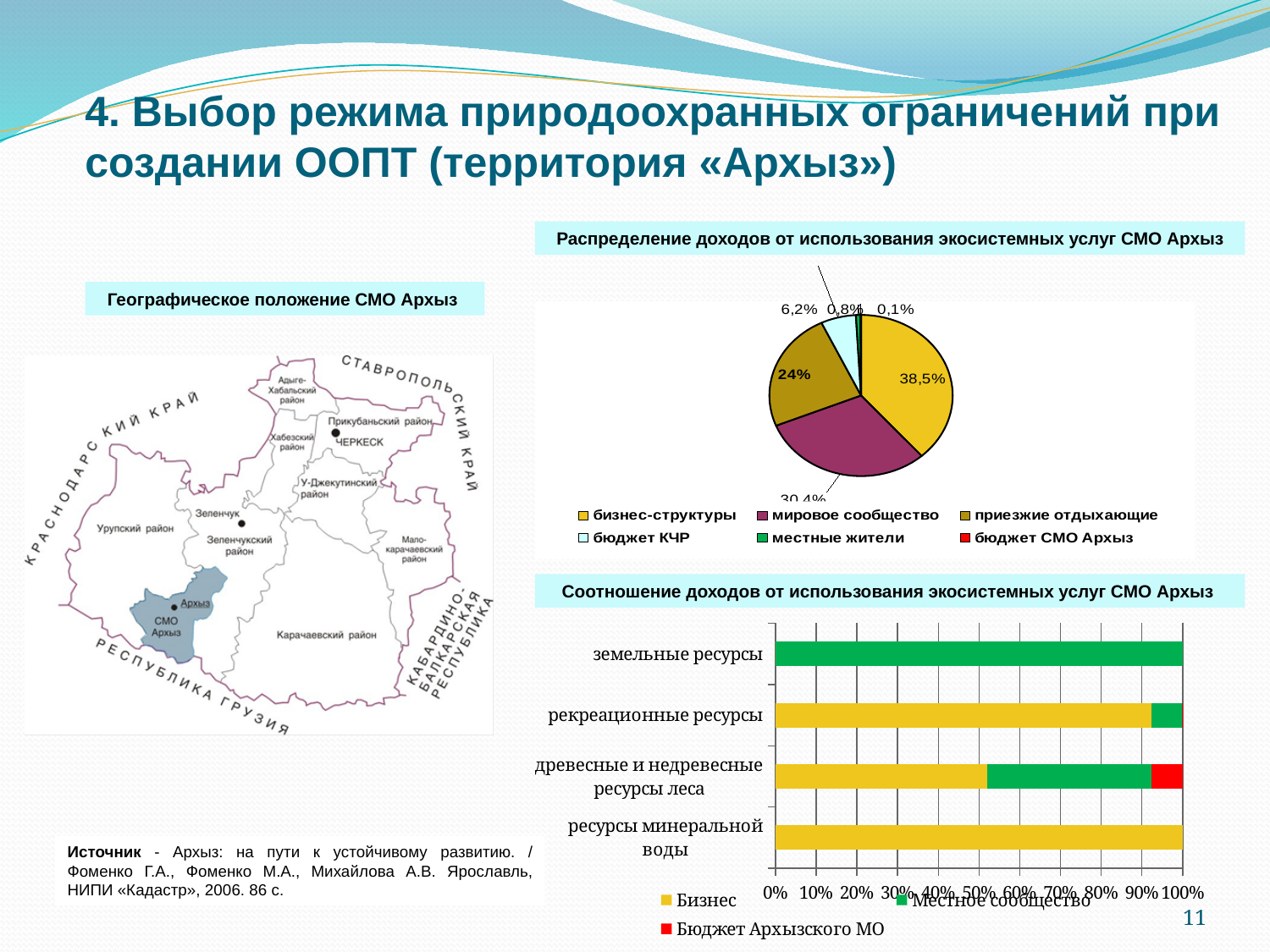
In the bar chart 'Соотношение доходов от использования экосистемных услуг СМО Архыз', is the Бизнес share for рекреационные ресурсы greater or less than 80%? greater In the pie chart 'Распределение доходов от использования экосистемных услуг СМО Архыз', what share is shown for приезжие отдыхающие? 24% What kind of chart is 'Соотношение доходов от использования экосистемных услуг СМО Архыз'? Stacked bar chart In the pie chart 'Распределение доходов от использования экосистемных услуг СМО Архыз', how many categories does the legend list? 6 In the pie chart 'Распределение доходов от использования экосистемных услуг СМО Архыз', what share is shown for бюджет КЧР? 6,2% In the pie chart 'Распределение доходов от использования экосистемных услуг СМО Архыз', what share is shown for бизнес-структуры? 38,5% In the pie chart 'Распределение доходов от использования экосистемных услуг СМО Архыз', which category has the largest share? бизнес-структуры In the bar chart 'Соотношение доходов от использования экосистемных услуг СМО Архыз', how many resource categories are shown? 4 In the pie chart 'Распределение доходов от использования экосистемных услуг СМО Архыз', what is the difference between the shares of бизнес-структуры and приезжие отдыхающие? 14,5% In the pie chart 'Распределение доходов от использования экосистемных услуг СМО Архыз', which category has the smallest share? бюджет СМО Архыз In the bar chart 'Соотношение доходов от использования экосистемных услуг СМО Архыз', which has the larger Бизнес share: рекреационные ресурсы or древесные и недревесные ресурсы леса? рекреационные ресурсы In the bar chart 'Соотношение доходов от использования экосистемных услуг СМО Архыз', how many series does the legend list? 3